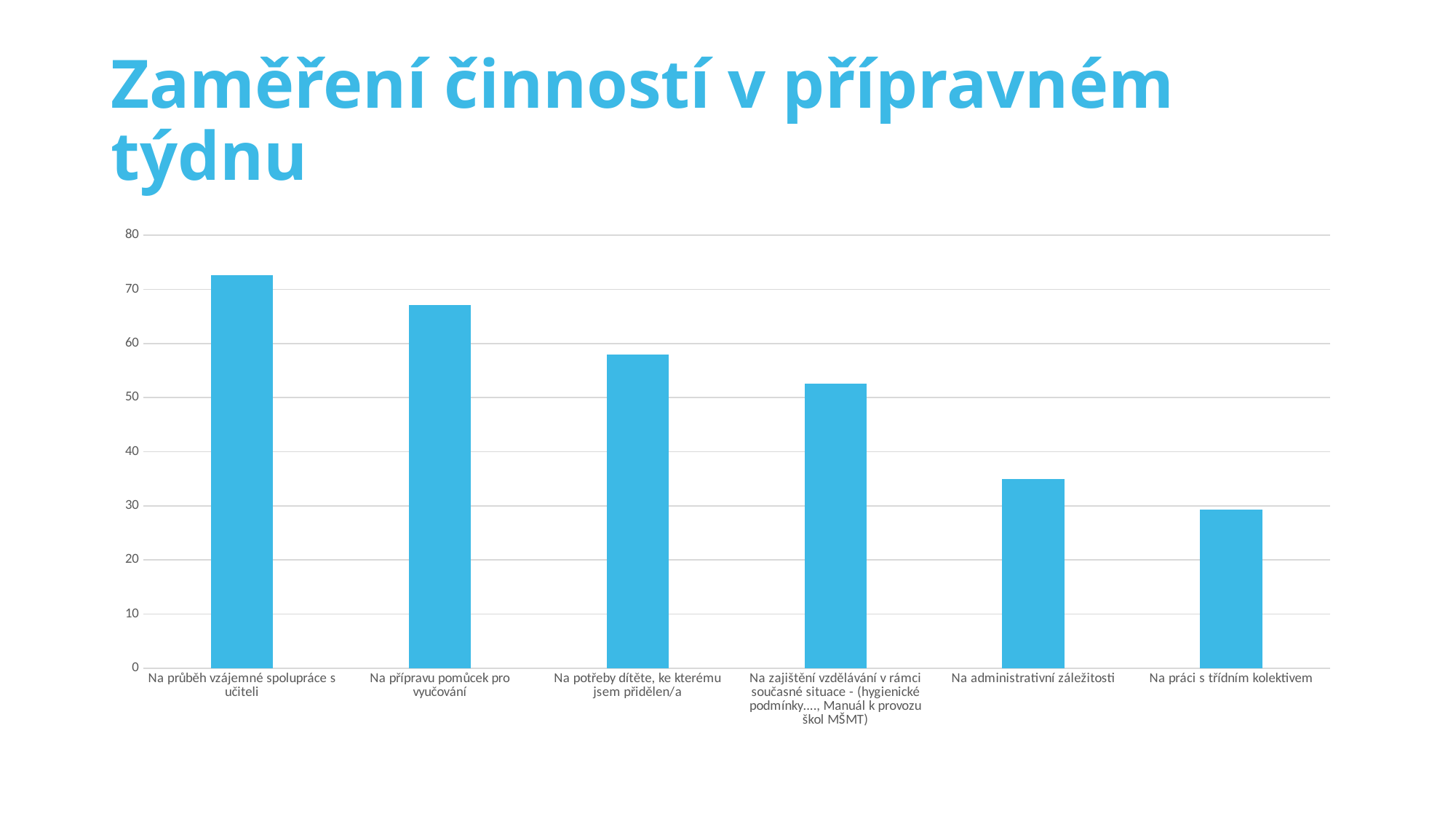
What is the title of the slide containing the chart? Zaměření činností v přípravném týdnu Is the value for "Na potřeby dítěte, ke kterému jsem přidělen/a" greater or less than 50? greater Which category has the highest bar? Na průběh vzájemné spolupráce s učiteli How many categories are shown on the x axis of the chart? 6 Which is larger: the value for "Na přípravu pomůcek pro vyučování" or the value for "Na administrativní záležitosti"? Na přípravu pomůcek pro vyučování Is the value for "Na průběh vzájemné spolupráce s učiteli" greater or less than 70? greater Which category has the lowest bar? Na práci s třídním kolektivem Is the value for "Na administrativní záležitosti" greater or less than 40? less Do the bar values rise or fall from left to right along the x axis? fall What is the highest value shown on the vertical axis of the chart? 80 What kind of chart is shown on the slide? bar chart